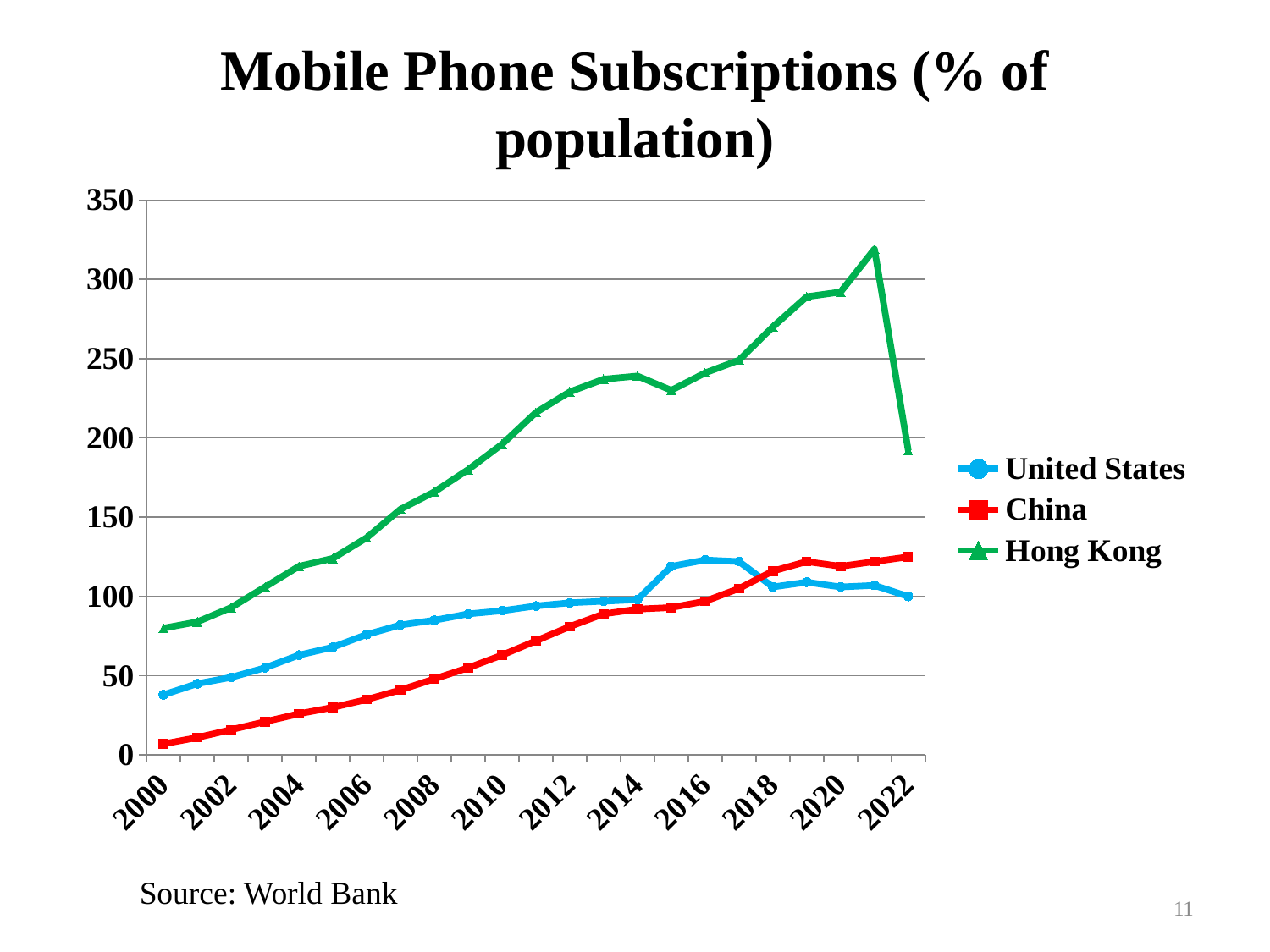
Is the value for China in 2000 greater or less than 50? less Does the China series generally rise or fall from 2000 to 2022? rise Is the value for the United States in 2016 greater or less than 100? greater Which series has the highest value in 2010? Hong Kong What is the title of the chart? Mobile Phone Subscriptions (% of population) What source is cited for the chart data? World Bank In 2022, which is larger: the value for China or the value for the United States? China What kind of chart is shown on the slide? line chart Which series has the lowest value in 2000? China Is the value for Hong Kong in 2022 greater or less than 200? less How many series does the legend list? 3